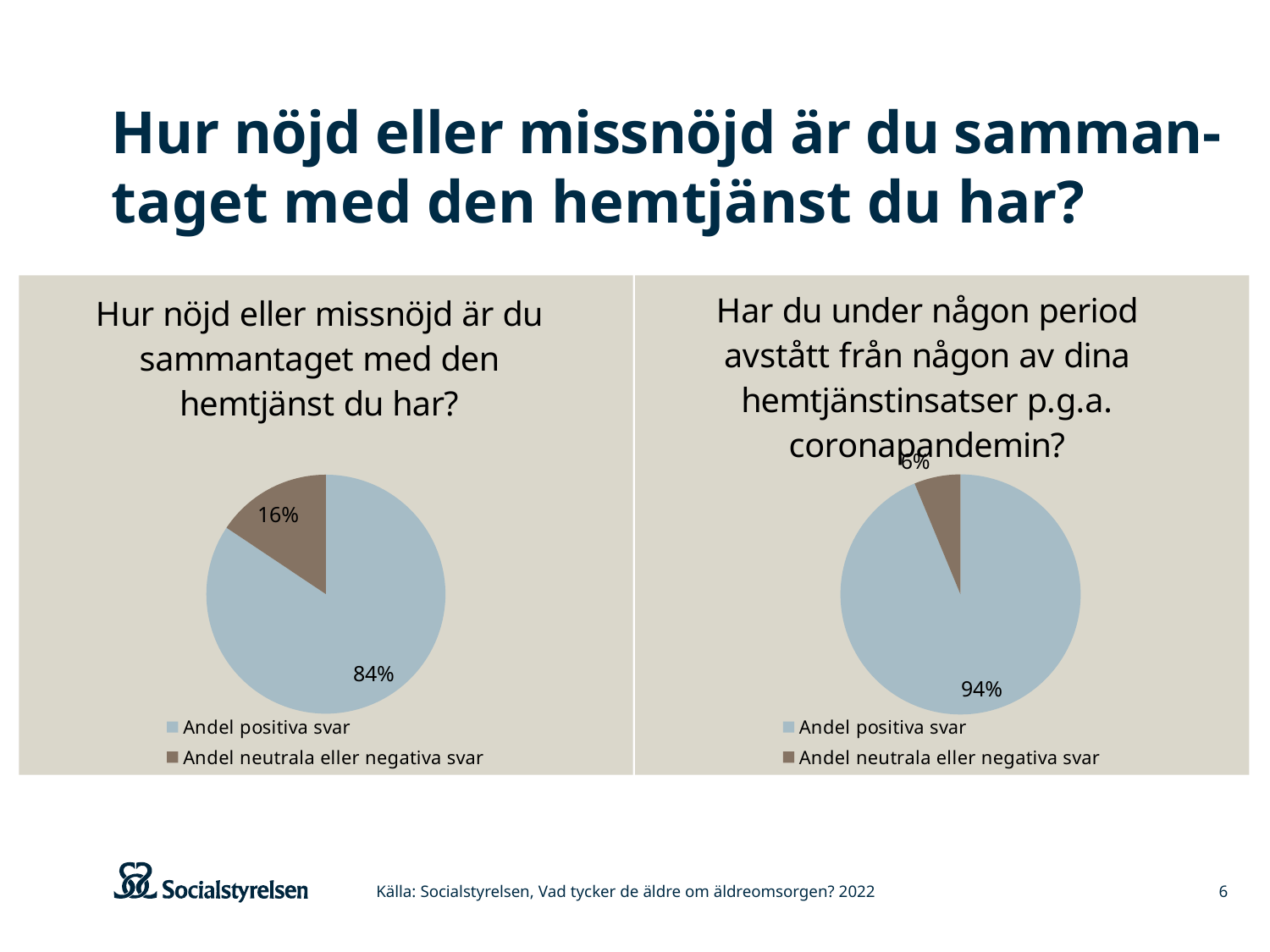
What is the title of the right pie chart? Har du under någon period avstått från någon av dina hemtjänstinsatser p.g.a. coronapandemin? In the left pie chart, what is the value for 'Andel positiva svar'? 84% In the left pie chart, what is the difference between 'Andel positiva svar' and 'Andel neutrala eller negativa svar'? 68 percentage points In the left pie chart, which category has the largest slice? Andel positiva svar In the right pie chart, which category has the smallest slice? Andel neutrala eller negativa svar In the right pie chart, what is the value for 'Andel neutrala eller negativa svar'? 6% In the right pie chart, what is the value for 'Andel positiva svar'? 94% In the left pie chart, what is the value for 'Andel neutrala eller negativa svar'? 16% Which is larger: 'Andel positiva svar' in the left pie chart or 'Andel positiva svar' in the right pie chart? The right pie chart How many entries does the legend of the left pie chart list? 2 How many slices does the right pie chart have? 2 What type of chart is shown on the left side of the slide? Pie chart